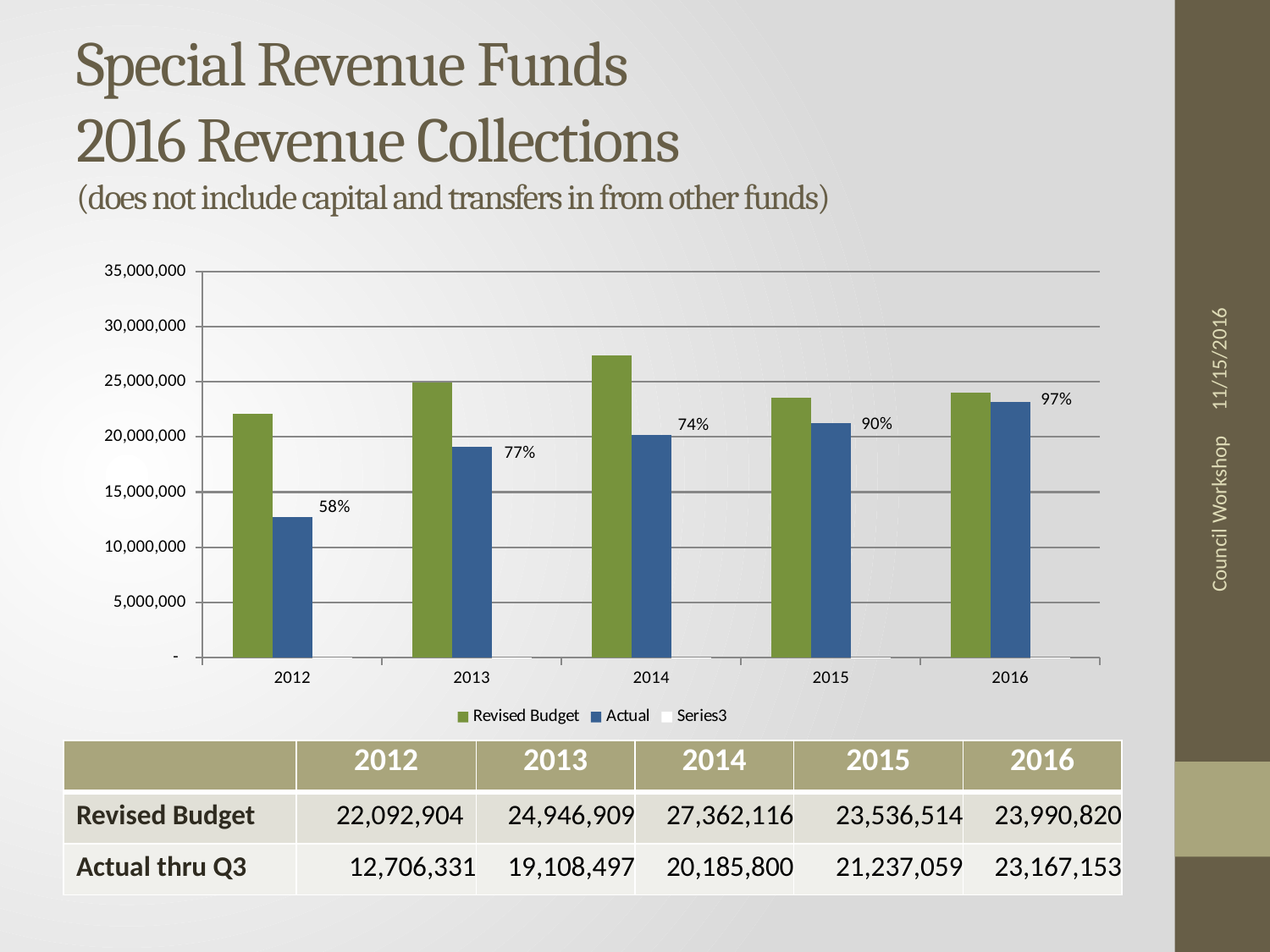
Is the Revised Budget bar for 2014 greater or less than 25,000,000? greater Which year has the highest Revised Budget bar? 2014 What is the difference between the Revised Budget and the Actual thru Q3 for 2016, using the values in the table? 823,667 Which year has the lowest Actual bar? 2012 How many years are shown on the x axis of the chart? 5 What is the Revised Budget value for 2014 according to the table below the chart? 27,362,116 How many series does the chart legend list? 3 What kind of chart is shown on the slide? bar chart Which is larger, the Actual bar for 2013 or the Actual bar for 2014? 2014 Is the Actual bar for 2012 greater or less than 15,000,000? less What percentage label is shown next to the Actual bar for 2016? 97% What percentage label is shown above the Actual bar for 2012? 58%